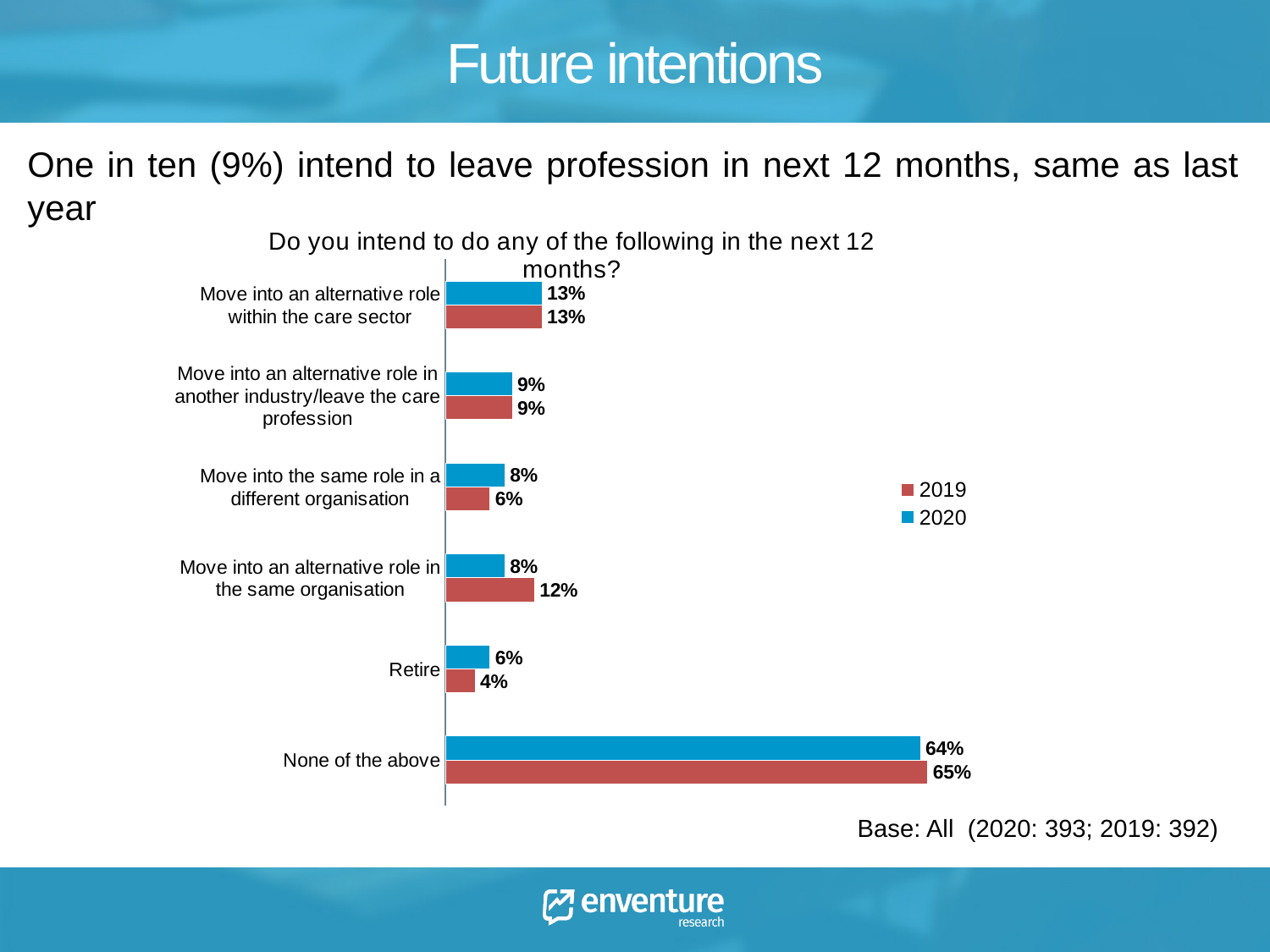
For "Move into the same role in a different organisation", which year has the larger value, 2019 or 2020? 2020 Which category has the lowest 2019 value? Retire What is the 2019 value for "None of the above"? 65% What is the 2020 value for "Retire"? 6% What kind of chart is shown on the slide? Bar chart What is the 2019 value for "Move into an alternative role in the same organisation"? 12% Which colour represents the 2019 series in the chart? Red How many series does the legend list? 2 What is the difference between the 2019 and 2020 values for "Move into an alternative role in the same organisation"? 4% What is the 2020 value for "Move into an alternative role within the care sector"? 13% How many categories are shown on the chart? 6 Which category has the highest 2020 value? None of the above